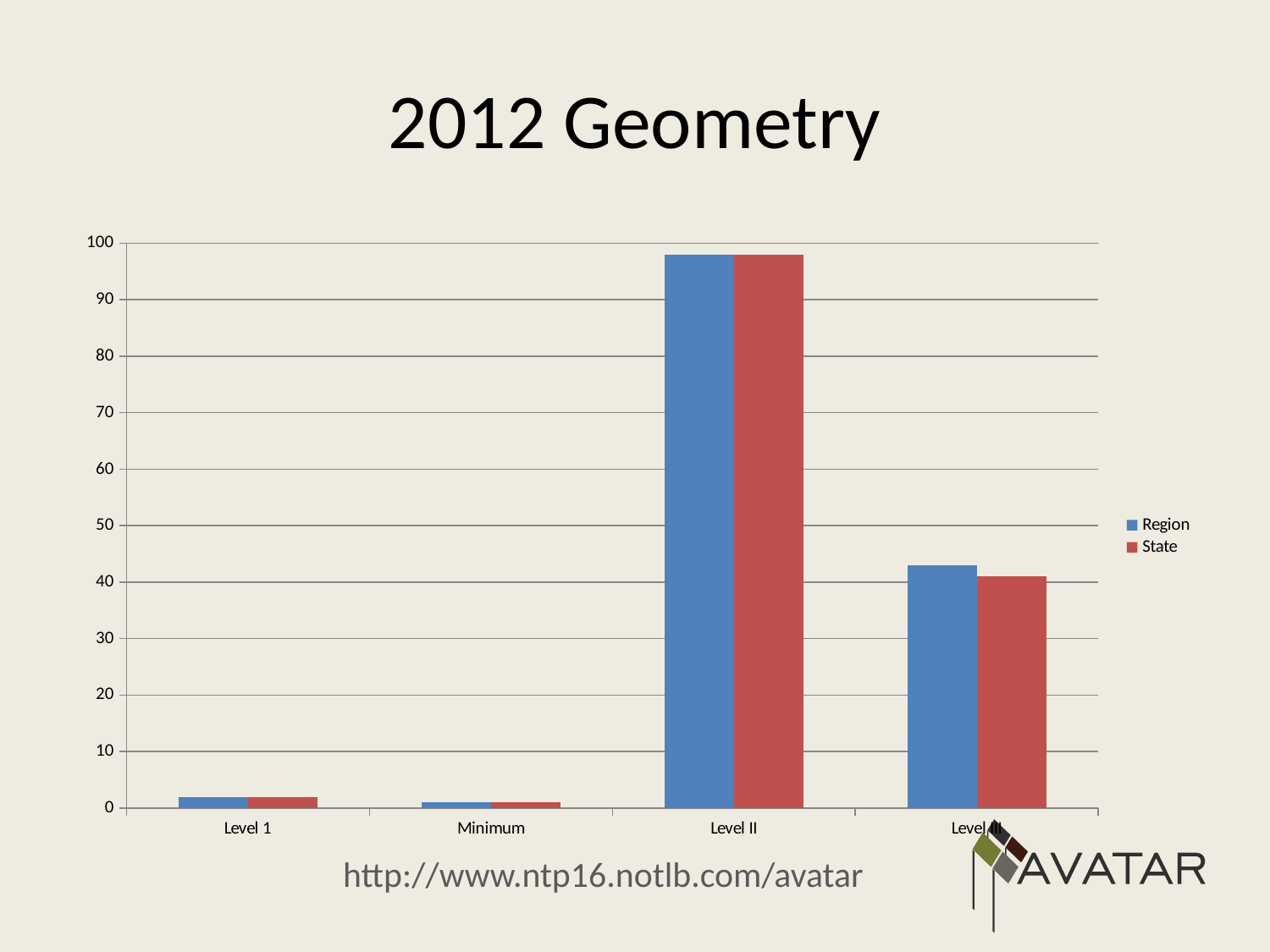
What is the title of the chart? 2012 Geometry How many categories are shown on the x axis? 4 Is the Region value for Level 1 greater or less than 10? less Is the Region value for Level III greater or less than 40? greater What are the two series named in the legend? Region and State For Level III, which is larger, the Region value or the State value? Region Is the Region value for Level II greater or less than 90? greater How many series does the legend list? 2 What type of chart is shown on the slide? bar chart Which category has the highest Region value? Level II Which category has the highest State value? Level II